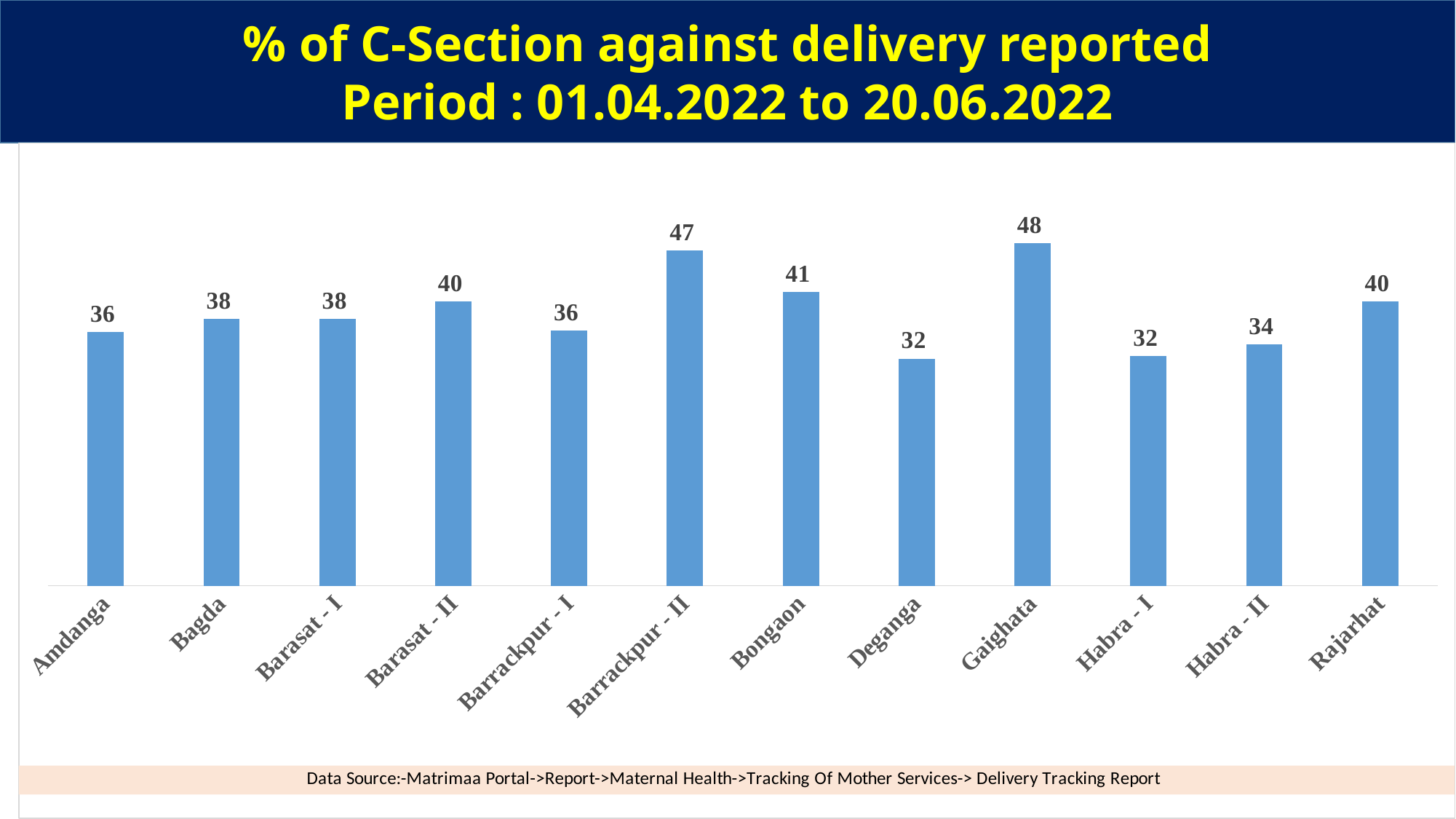
What is the value for Gaighata? 48 What kind of chart is shown on the slide? Bar chart What is the value for Barrackpur - II? 47 What is the value for Bongaon? 41 Which is larger, the value for Bongaon or the value for Habra - II? Bongaon What is the lowest value shown on the chart? 32 Which category has the highest value? Gaighata What is the value for Deganga? 32 What is the difference between the values for Barrackpur - II and Barrackpur - I? 11 What is the difference between the values for Gaighata and Deganga? 16 What period does the chart title say the data covers? 01.04.2022 to 20.06.2022 How many categories are shown on the chart? 12